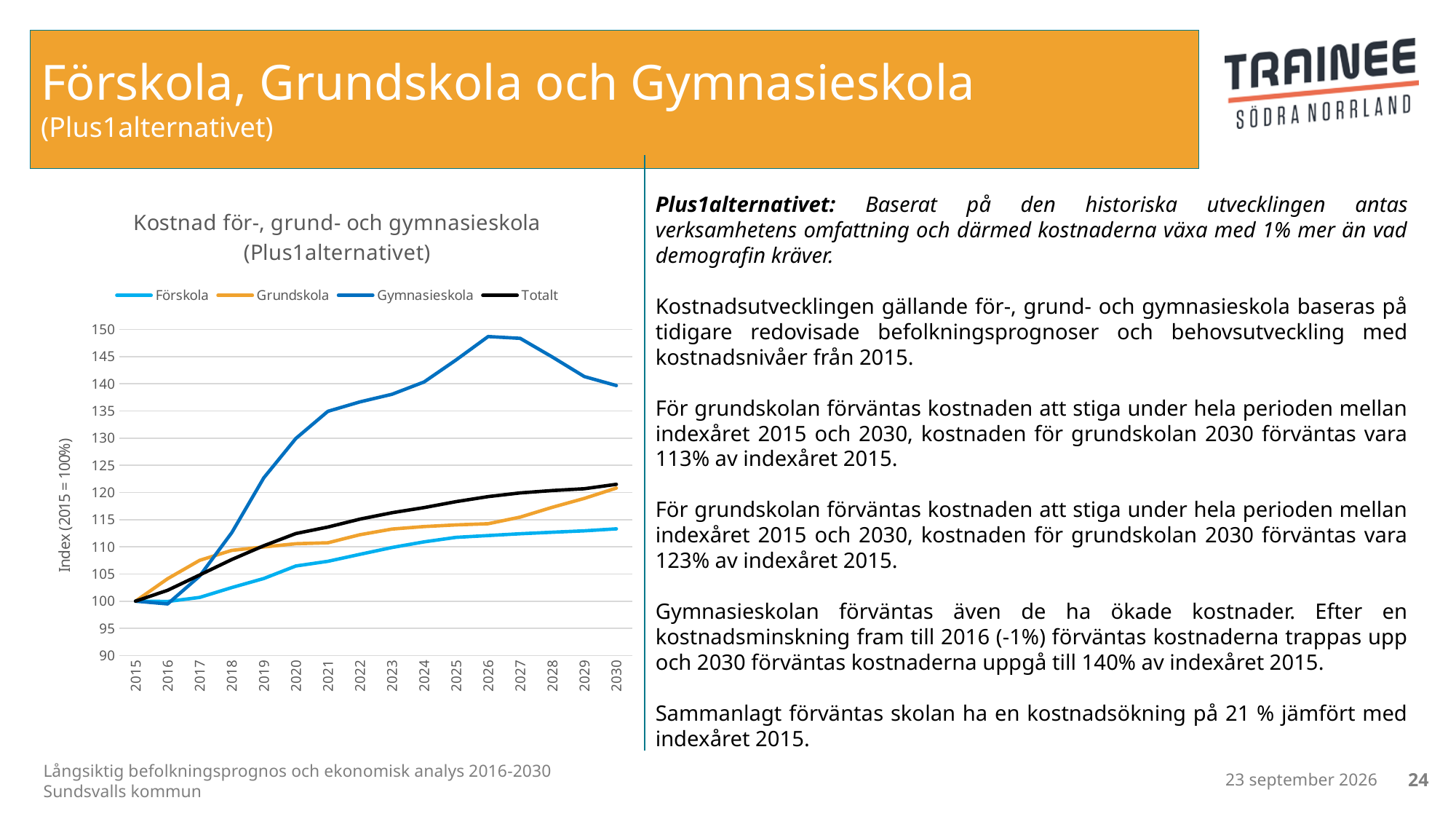
What kind of chart is shown on the slide? Line chart Is the value for Gymnasieskola in 2026 greater or less than 145? greater What is the index value for Totalt in 2015? 100 Which series has the lowest value in 2030? Förskola Which series has the highest value in 2030? Gymnasieskola Is the value for Gymnasieskola in 2016 greater or less than 105? less In 2020, which is higher: Grundskola or Förskola? Grundskola What is the label on the y axis of the chart? Index (2015 = 100%) How many years are shown on the x axis of the chart? 16 Is the value for Förskola in 2030 greater or less than 110? greater How many series does the chart legend list? 4 Does the Förskola series rise or fall from 2015 to 2030? Rise